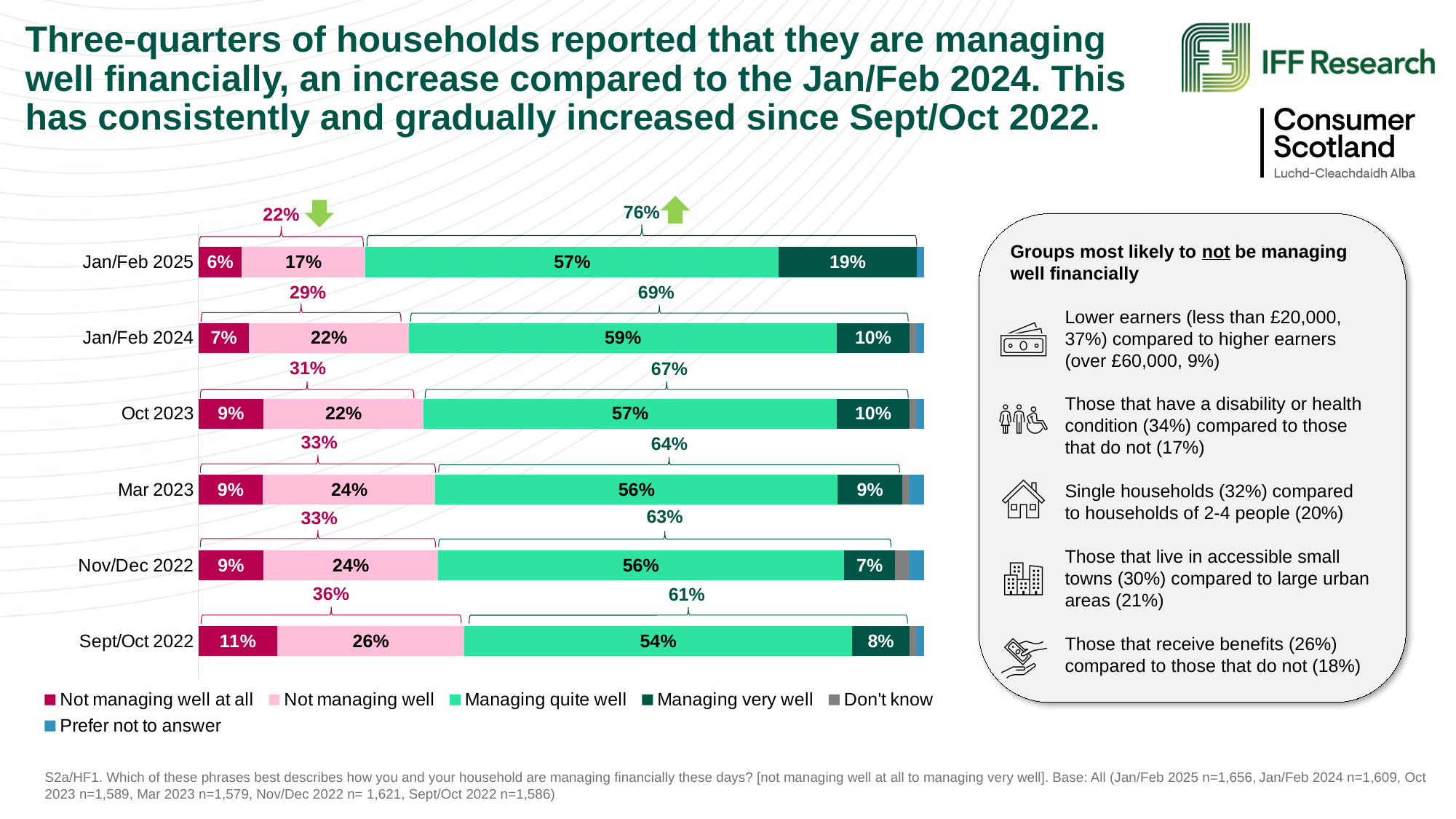
Which survey period has the lowest percentage of households 'Not managing well at all'? Jan/Feb 2025 What percentage of households were 'Not managing well at all' in Sept/Oct 2022? 11% How many survey periods are shown in the chart? 6 Does the combined 'managing well' percentage (shown above the green brackets) rise or fall from Sept/Oct 2022 to Jan/Feb 2025? Rise Which period had a higher 'Not managing well' percentage, Mar 2023 or Oct 2023? Mar 2023 By how many percentage points did 'Managing very well' increase from Jan/Feb 2024 to Jan/Feb 2025? 9 percentage points What percentage of households were 'Managing very well' in Jan/Feb 2024? 10% What is the combined 'not managing well' percentage shown above the bracket for Nov/Dec 2022? 33% What percentage of households were 'Managing quite well' in Jan/Feb 2025? 57% How many response categories does the legend list? 6 Which survey period has the highest percentage of households 'Managing very well'? Jan/Feb 2025 What type of chart is used to show how households are managing financially? Stacked bar chart